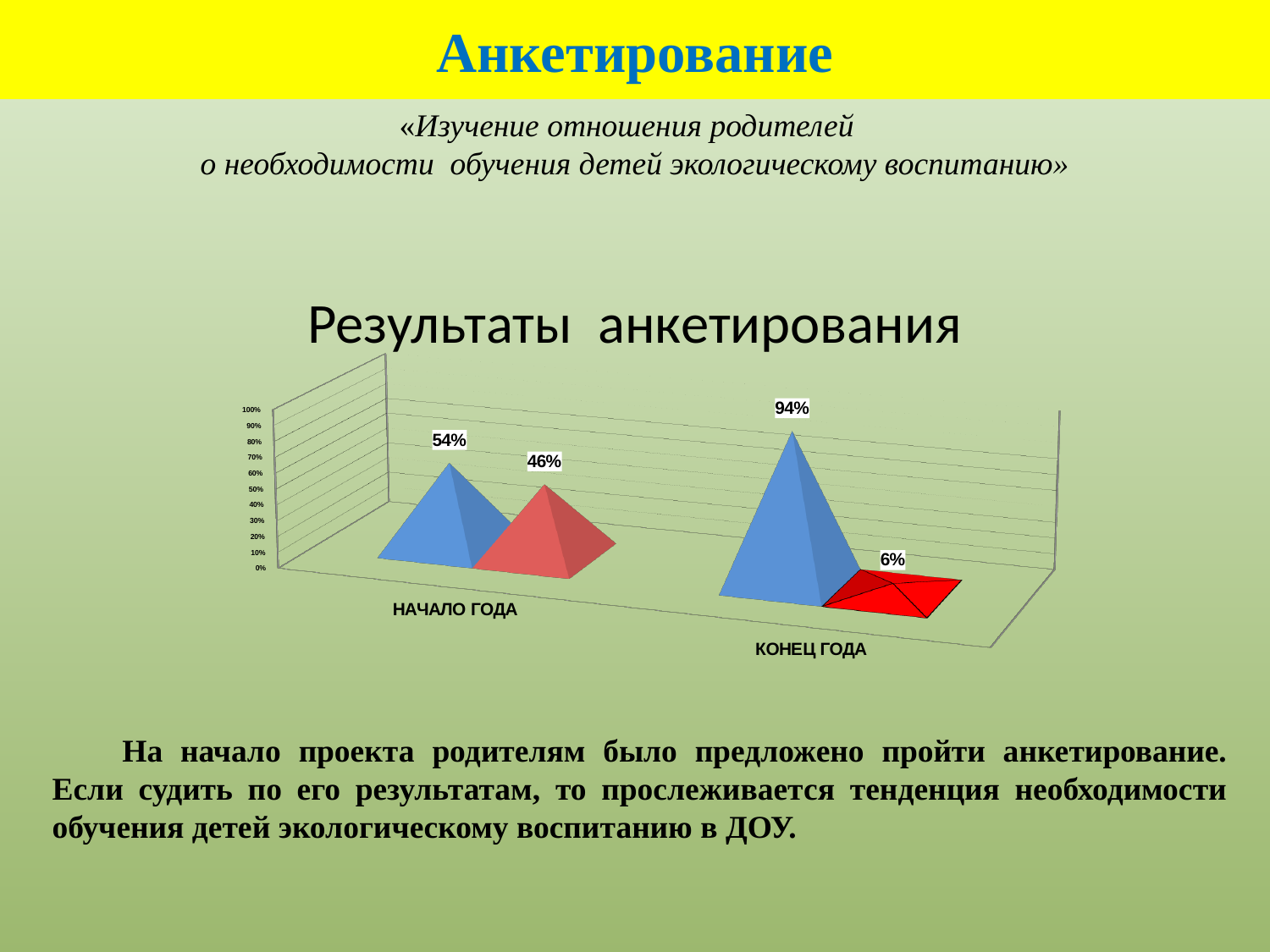
Which category has the highest value in the blue series? КОНЕЦ ГОДА How many categories are shown on the x axis? 2 Which is larger for НАЧАЛО ГОДА, the blue series or the red series? the blue series What is the title of the chart? Результаты анкетирования What is the value of the red series for НАЧАЛО ГОДА? 46% What is the difference between the blue series values for КОНЕЦ ГОДА and НАЧАЛО ГОДА? 40% What is the value of the red series for КОНЕЦ ГОДА? 6% What is the value of the blue series for НАЧАЛО ГОДА? 54% Which category has the lowest value in the red series? КОНЕЦ ГОДА What is the value of the blue series for КОНЕЦ ГОДА? 94% What is the difference between the blue and red values for КОНЕЦ ГОДА? 88% Does the blue series rise or fall from НАЧАЛО ГОДА to КОНЕЦ ГОДА? rise